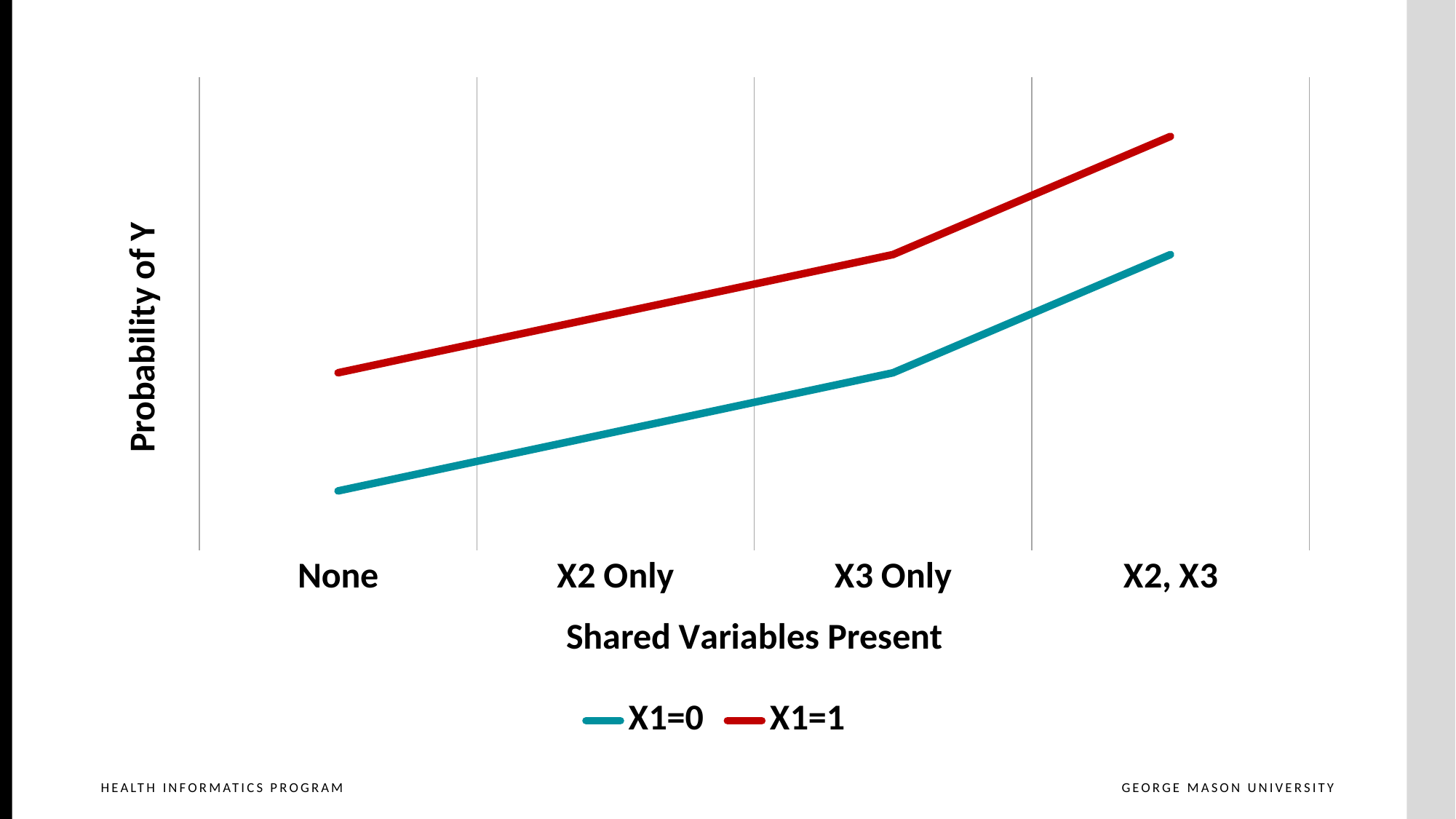
Do the values for the X1=1 series rise or fall from None to X2, X3? rise For which category is the X1=1 series highest? X2, X3 Do the values for the X1=0 series rise or fall along the x axis? rise At the X3 Only category, which series has the higher probability of Y, X1=0 or X1=1? X1=1 How many categories are shown on the x axis? 4 What kind of chart is shown on the slide? line chart At the None category, which series has the lower probability of Y, X1=0 or X1=1? X1=0 What is the title of the x axis? Shared Variables Present For which category is the X1=0 series lowest? None What is the title of the y axis? Probability of Y How many series does the legend list? 2